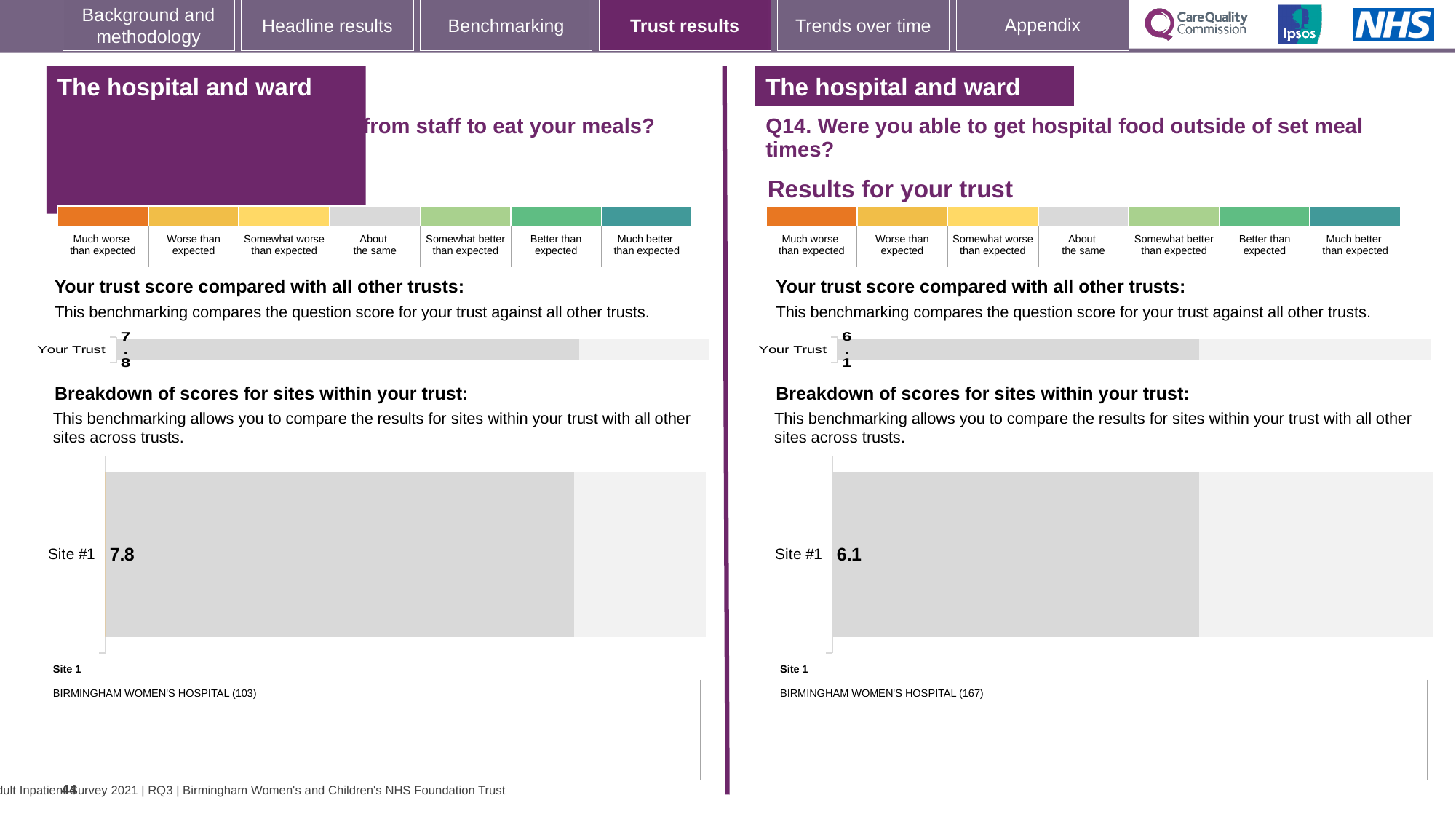
What is the difference between the Site #1 score on the left-hand breakdown chart and the Site #1 score on the right-hand Q14 breakdown chart? 1.7 What kind of chart is used to show the Site #1 score on the right-hand Q14 breakdown chart? Bar chart On the right-hand 'Breakdown of scores for sites within your trust' chart for Q14, what is the score for Site #1? 6.1 Which Site #1 score is larger: the one on the left-hand breakdown chart or the one on the right-hand Q14 breakdown chart? The left-hand chart (7.8) How many rating categories are shown in the colour scale above the right-hand Q14 charts? 7 On the left-hand 'Your trust score compared with all other trusts' chart, what is the score shown for Your Trust? 7.8 Which Your Trust score is larger: the one on the left-hand chart or the one on the right-hand Q14 chart? The left-hand chart (7.8) On the left-hand 'Breakdown of scores for sites within your trust' chart, what is the score for Site #1? 7.8 How many sites are shown on the right-hand 'Breakdown of scores for sites within your trust' chart for Q14? 1 On the right-hand chart for Q14 (hospital food outside of set meal times), what is the score shown for Your Trust? 6.1 On the left-hand breakdown chart, what number appears in parentheses after the Site 1 hospital name? 103 On the right-hand Q14 breakdown chart, which hospital is listed as Site 1? BIRMINGHAM WOMEN'S HOSPITAL (167)